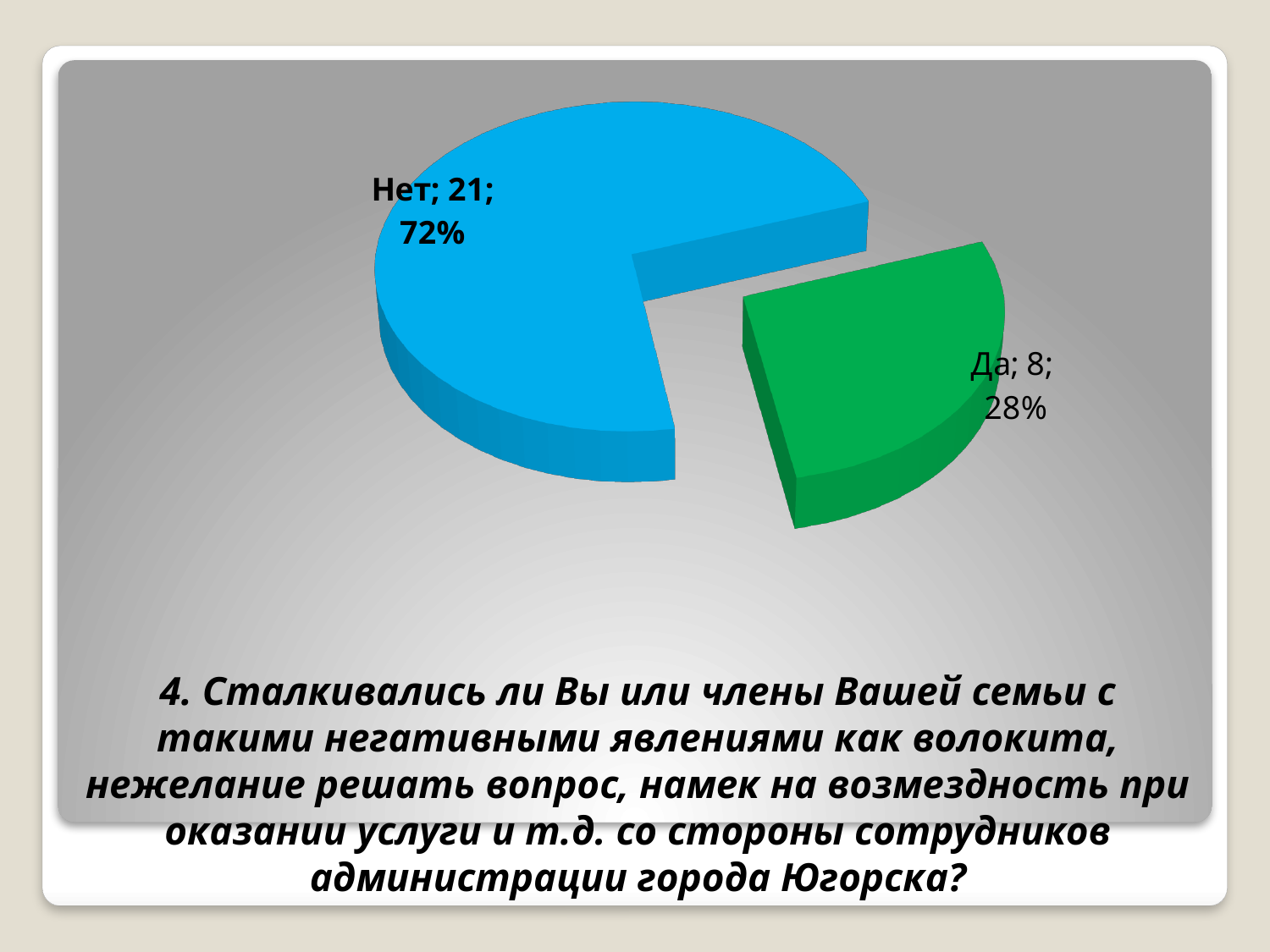
How many slices does the pie chart have? 2 What is the value for "Нет"? 21 What is the difference between the values for "Нет" and "Да"? 13 What share of the pie does "Да" represent? 28% Which is larger, the value for "Да" or the value for "Нет"? Нет What is the value for "Да"? 8 What is the total of the two slice values? 29 Which slice is the largest? Нет What kind of chart is shown on the slide? pie chart What colour is the "Да" slice? green What share of the pie does "Нет" represent? 72% Which slice is the smallest? Да